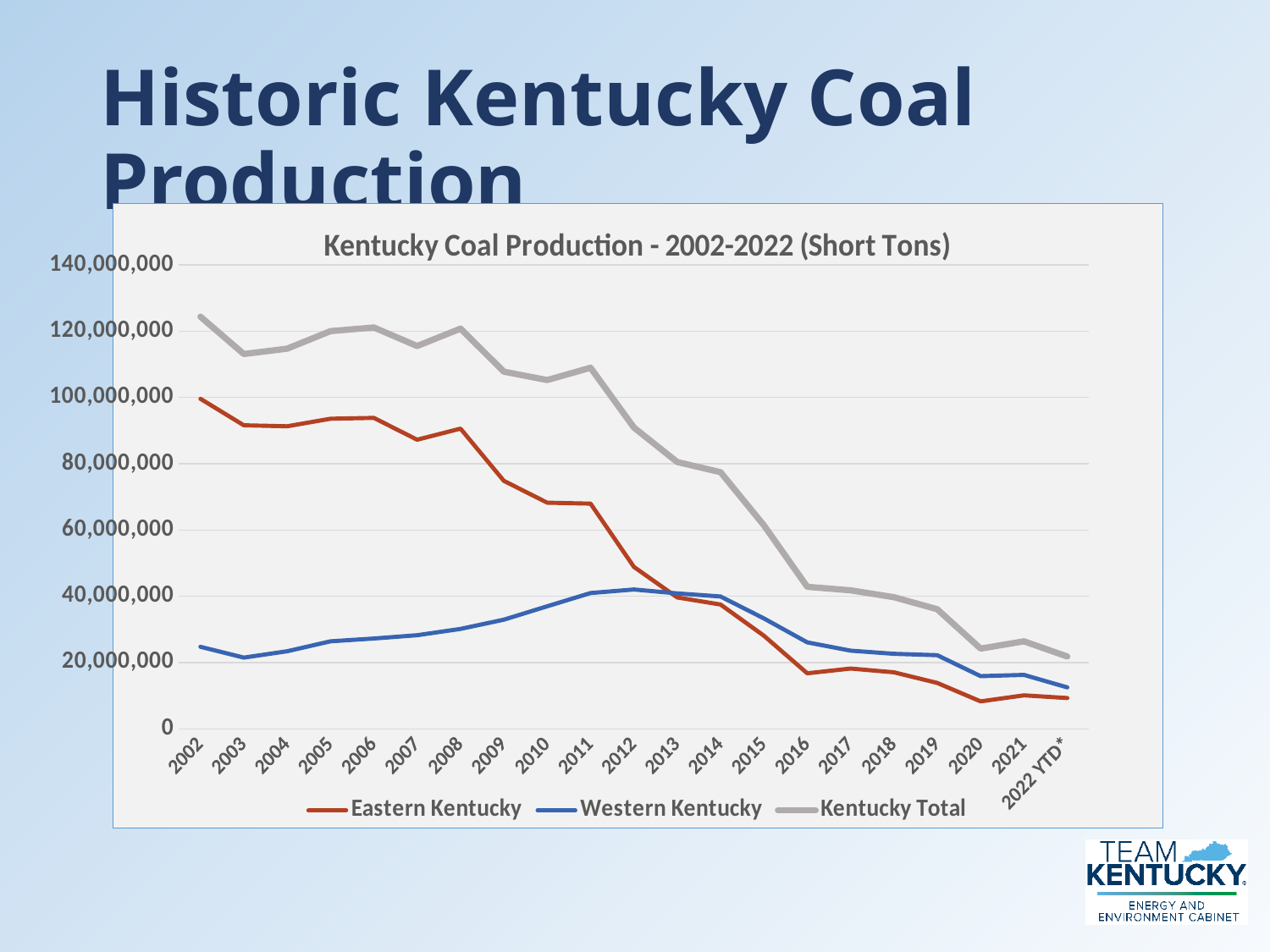
How many series does the legend list? 3 Does Eastern Kentucky coal production rise or fall overall from 2002 to 2022 YTD*? Fall Is the Eastern Kentucky value for 2002 greater or less than 80,000,000? greater Which series is drawn in grey? Kentucky Total In which year is Kentucky Total production highest? 2002 Is the Eastern Kentucky value for 2016 greater or less than 20,000,000? less In which year is Eastern Kentucky production highest? 2002 How many years (points) are shown along the x axis? 21 What kind of chart is shown on the slide? Line chart What is the title of the chart? Kentucky Coal Production - 2002-2022 (Short Tons) Does Kentucky Total coal production rise or fall overall from 2002 to 2022 YTD*? Fall Which series has the larger value in 2016, Eastern Kentucky or Western Kentucky? Western Kentucky